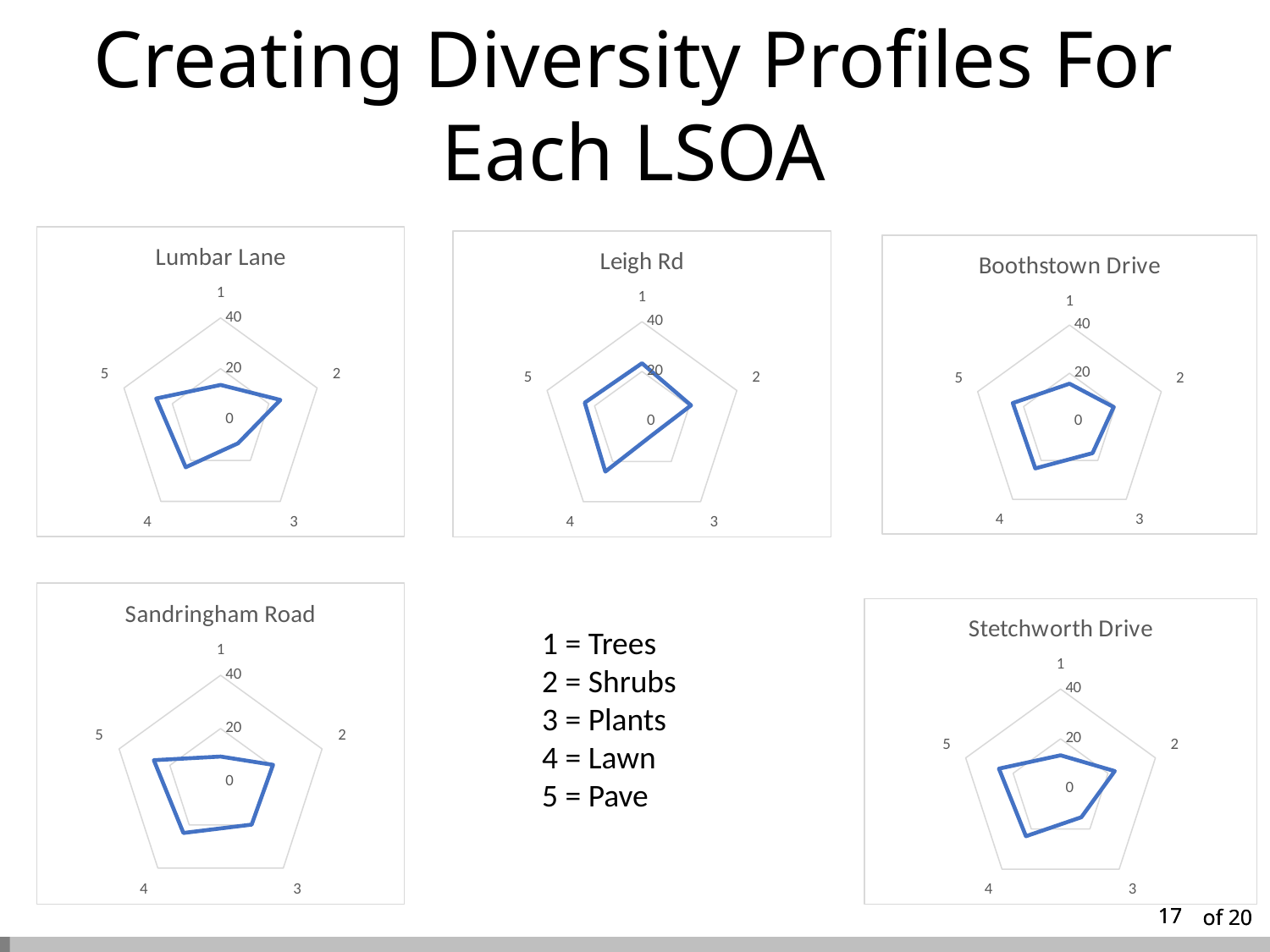
On the Lumbar Lane chart, is the value for category 5 greater or less than 20? greater What is the highest axis value shown on the Stetchworth Drive chart? 40 On the Stetchworth Drive chart, is the value for category 1 greater or less than 20? less According to the key on the slide, what does category 4 represent in the charts? Lawn What kind of chart is the Lumbar Lane chart? radar chart On the Boothstown Drive chart, is the value for category 1 greater or less than 20? less How many categories are plotted on the Lumbar Lane chart? 5 On the Leigh Rd chart, which category has the lowest value? 3 On the Sandringham Road chart, which category has the lowest value? 1